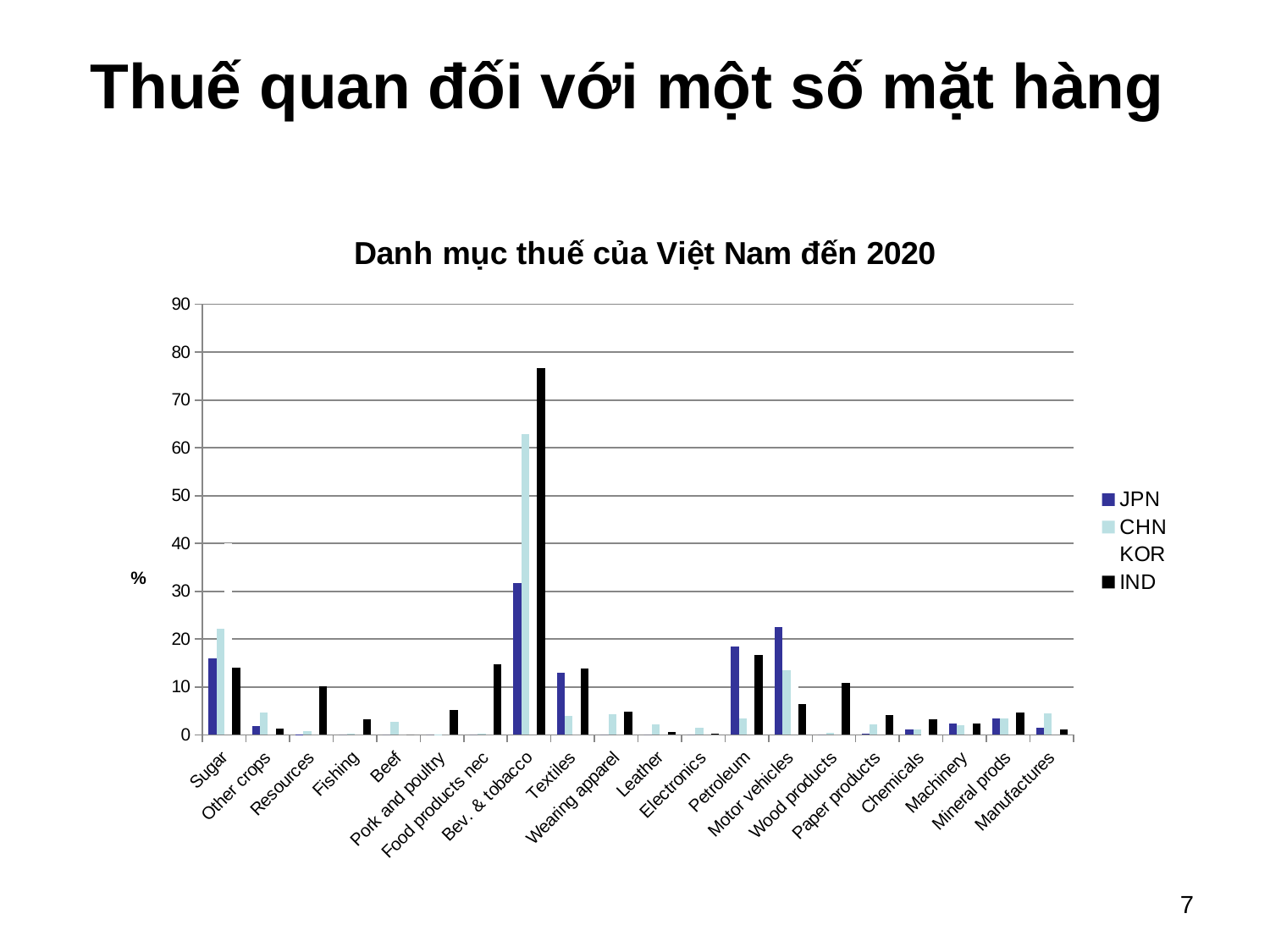
For Sugar, which is larger: the CHN value or the JPN value? CHN For Motor vehicles, which is larger: the JPN value or the CHN value? JPN What kind of chart is shown on the slide? Bar chart How many product categories are shown on the x axis? 20 How many series does the chart legend list? 4 Which category has the highest IND value? Bev. & tobacco Which category has the highest CHN value? Bev. & tobacco Is the IND value for Bev. & tobacco greater or less than 70? greater Is the JPN value for Sugar greater or less than 20? less Is the JPN value for Motor vehicles greater or less than 20? greater What is the title of the chart? Danh mục thuế của Việt Nam đến 2020